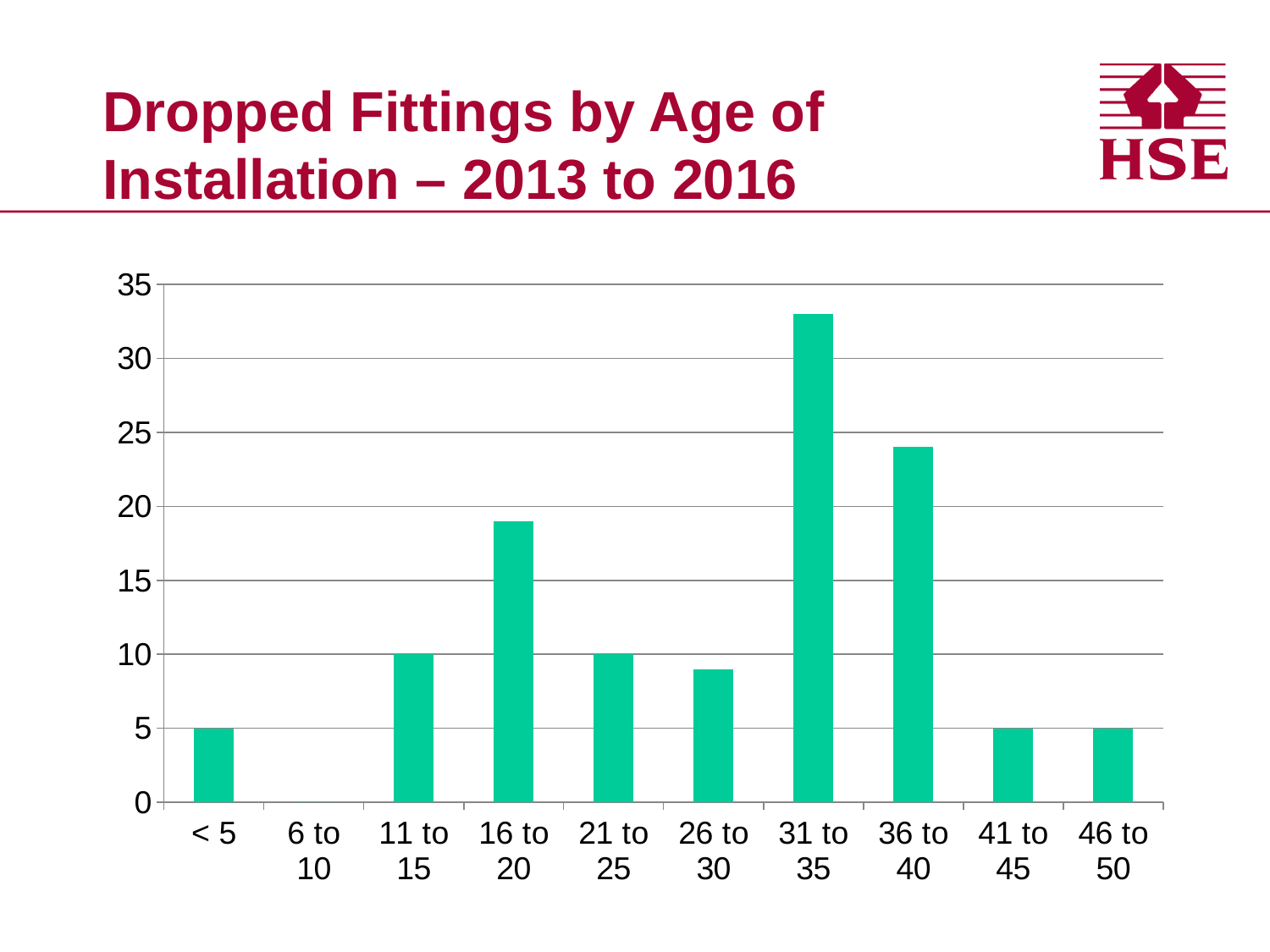
What is the value for the '< 5' category? 5 What is the value for the '46 to 50' category? 5 Which age category has the lowest number of dropped fittings? 6 to 10 What is the value for the '11 to 15' category? 10 What type of chart is shown on the slide? bar chart What is the title of the chart? Dropped Fittings by Age of Installation – 2013 to 2016 What is the difference between the values for '11 to 15' and '41 to 45'? 5 Which is larger, the value for '16 to 20' or the value for '36 to 40'? 36 to 40 Is the value for '36 to 40' greater or less than 25? less Which age category has the highest number of dropped fittings? 31 to 35 How many age-of-installation categories are shown on the x axis? 10 Is the value for '31 to 35' greater or less than 30? greater